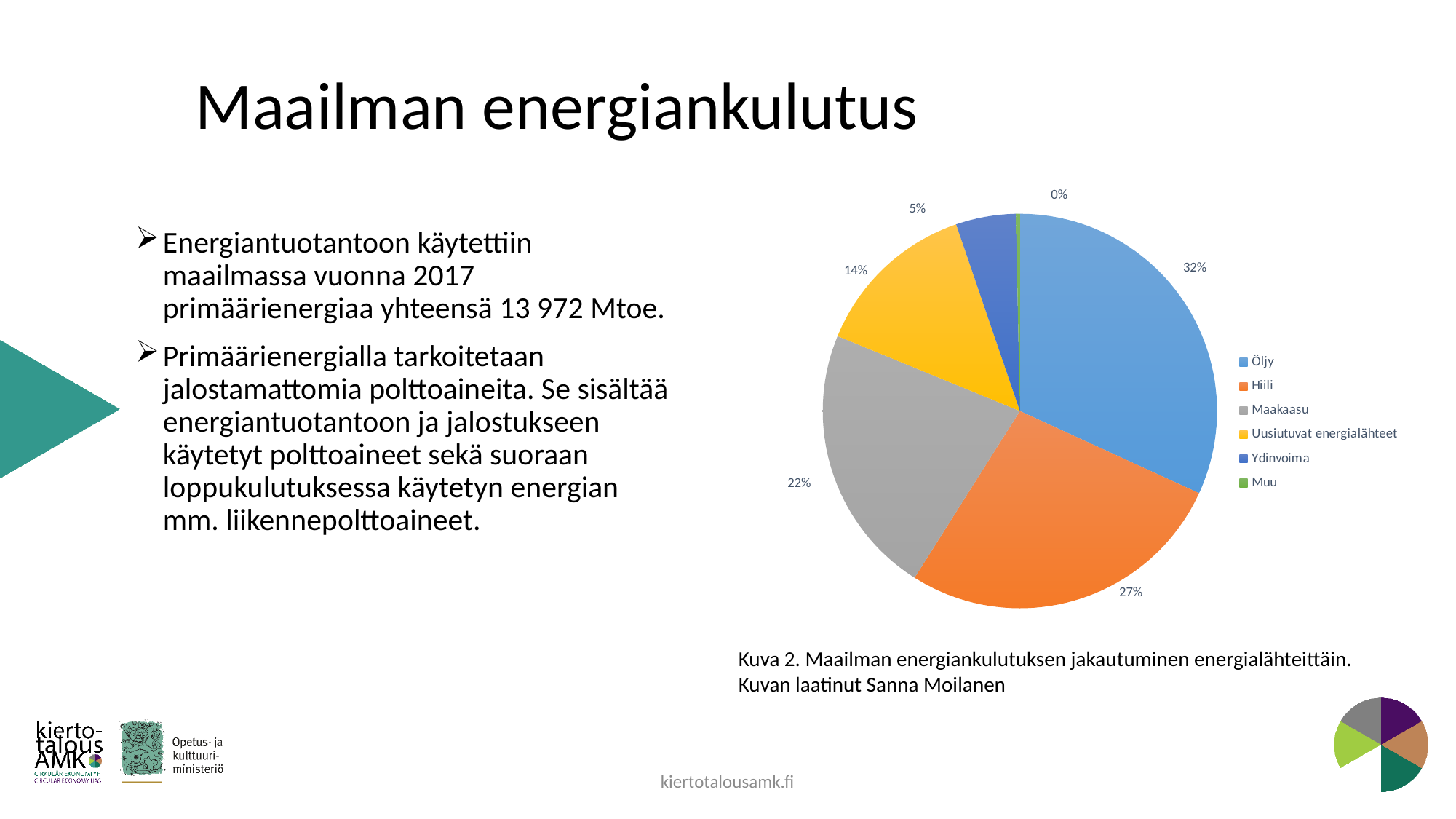
Which energy source has the largest slice of the pie? Öljy What share of the pie does Öljy have? 32% What colour is the Hiili slice in the pie chart? orange What kind of chart is shown on the slide? pie chart How many categories does the legend of the pie chart list? 6 What share of the pie does Hiili have? 27% What share of the pie does Maakaasu have? 22% What is the difference in percentage points between the Öljy and Hiili slices? 5 What share of the pie does Uusiutuvat energialähteet have? 14% Which slice is larger, Maakaasu or Uusiutuvat energialähteet? Maakaasu Which energy source has the smallest slice of the pie? Muu What share of the pie does Ydinvoima have? 5%